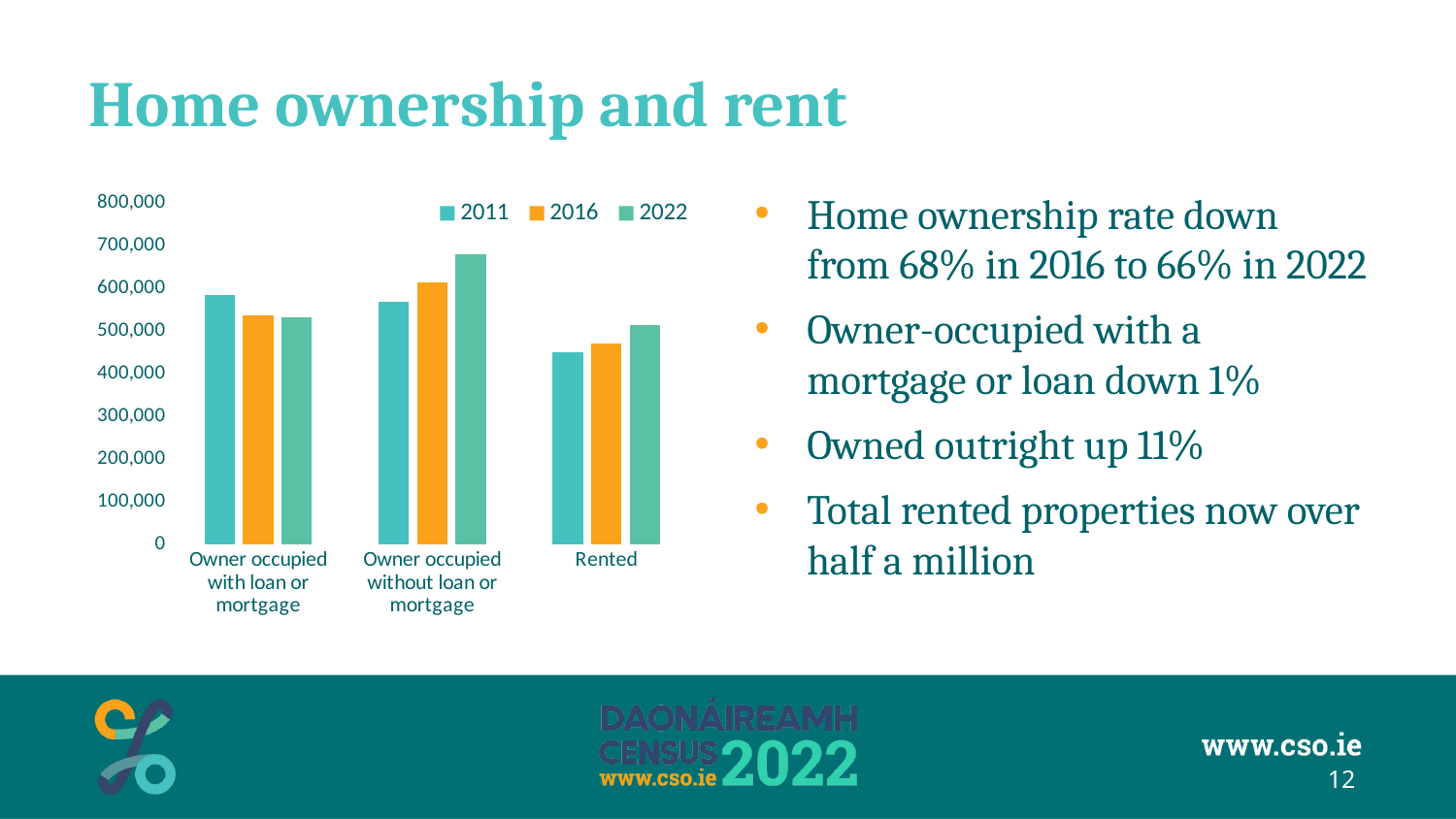
Is the 2011 value for Owner occupied with loan or mortgage greater or less than 500,000? greater Is the 2022 value for Owner occupied without loan or mortgage greater or less than 600,000? greater How many series does the chart's legend list? 3 Which category and year has the tallest bar in the chart? Owner occupied without loan or mortgage, 2022 Within the Rented category, which year has the highest value? 2022 How many categories are shown on the x axis of the chart? 3 Which is larger in 2022: Owner occupied without loan or mortgage, or Rented? Owner occupied without loan or mortgage Which years are listed in the chart's legend? 2011, 2016 and 2022 What kind of chart is shown on the slide? Bar chart Do the values for Rented rise or fall from 2011 to 2022? rise Which category and year has the shortest bar in the chart? Rented, 2011 Is the 2011 value for Rented greater or less than 500,000? less